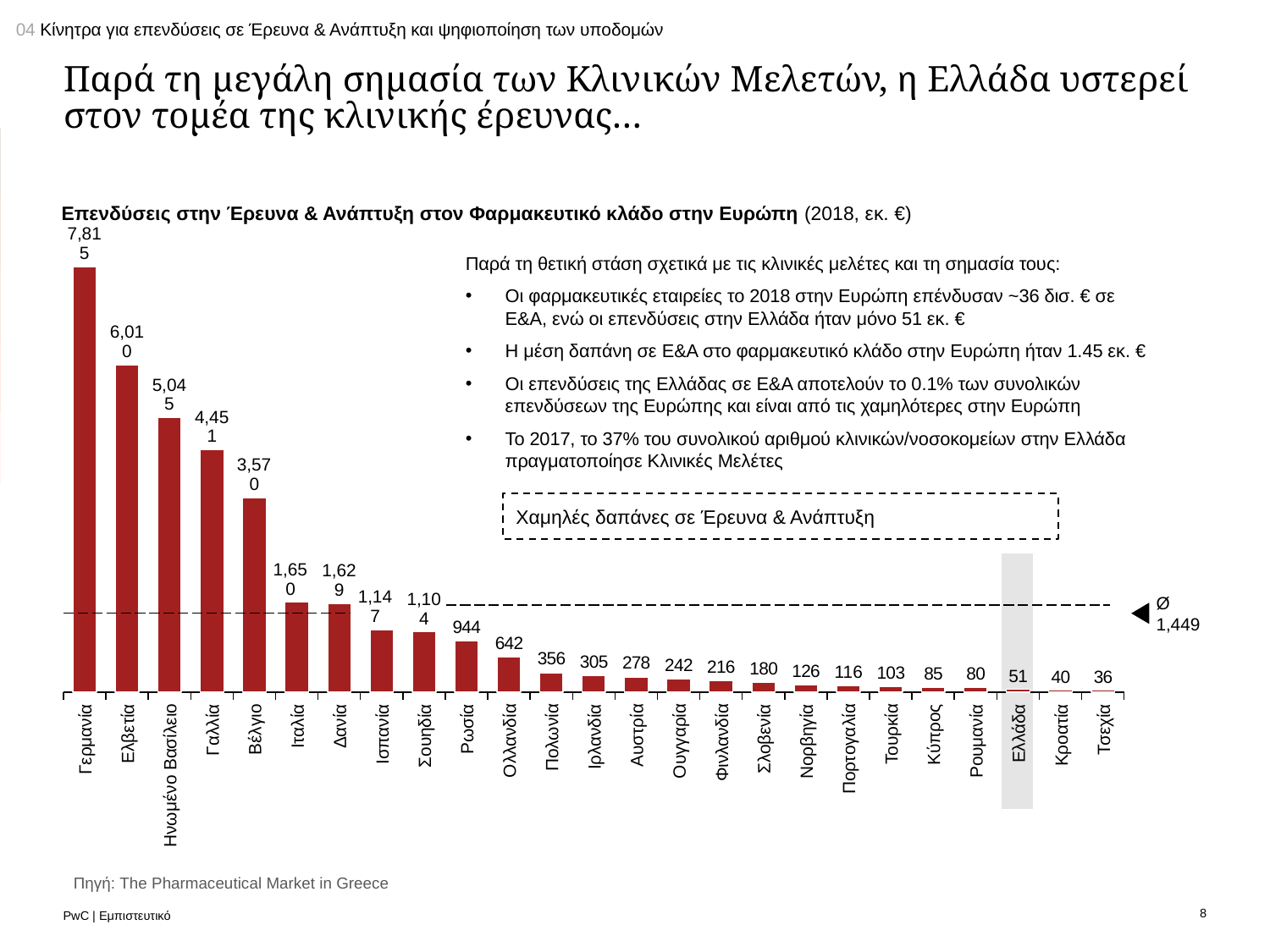
Do the values rise or fall from left to right along the x axis? Fall Which country has the highest value? Γερμανία What is the value for Ελλάδα? 51 Which is larger, the value for Πολωνία or the value for Ιρλανδία? Πολωνία What is the difference between the values for Κροατία and Τσεχία? 4 How many countries are shown on the chart? 25 What is the value for Γερμανία? 7,815 What is the difference between the values for Ελβετία and Ηνωμένο Βασίλειο? 965 Which country has the lowest value? Τσεχία What average value (Ø) is marked by the dashed line on the chart? 1,449 What kind of chart is this? Bar chart What is the value for Ρωσία? 944